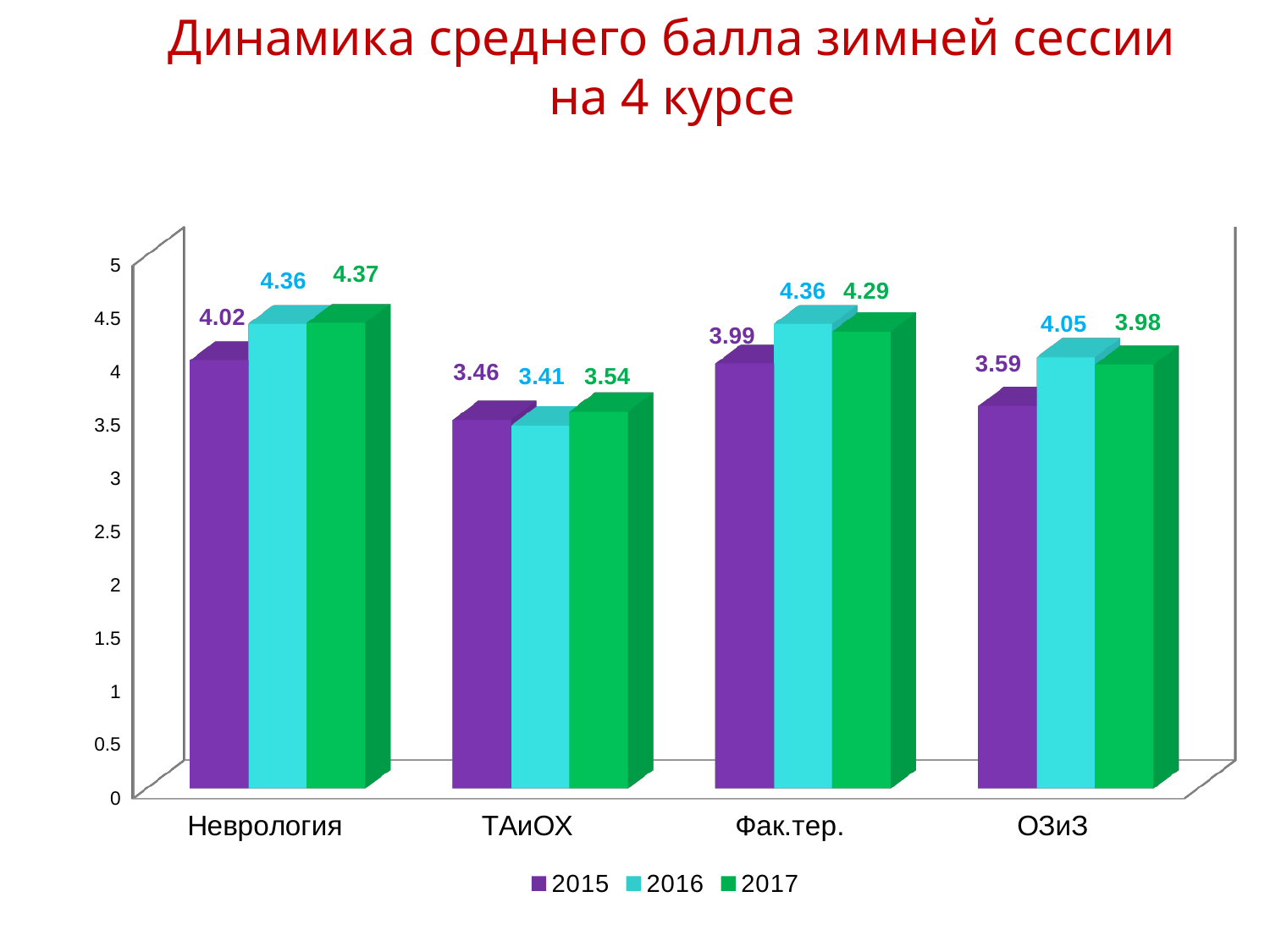
What colour represents the 2017 series? green What is the value for ТАиОХ in 2017? 3.54 Which is larger for Фак.тер.: the 2016 value or the 2017 value? 2016 Which category has the highest value in 2015? Неврология What is the difference between the 2017 and 2015 values for Неврология? 0.35 Do the values for ТАиОХ rise or fall from 2016 to 2017? rise Which category has the lowest value in 2016? ТАиОХ What is the value for Неврология in 2015? 4.02 How many series does the legend list? 3 What kind of chart is this? bar chart How many categories are shown on the x axis? 4 What is the value for ОЗиЗ in 2016? 4.05